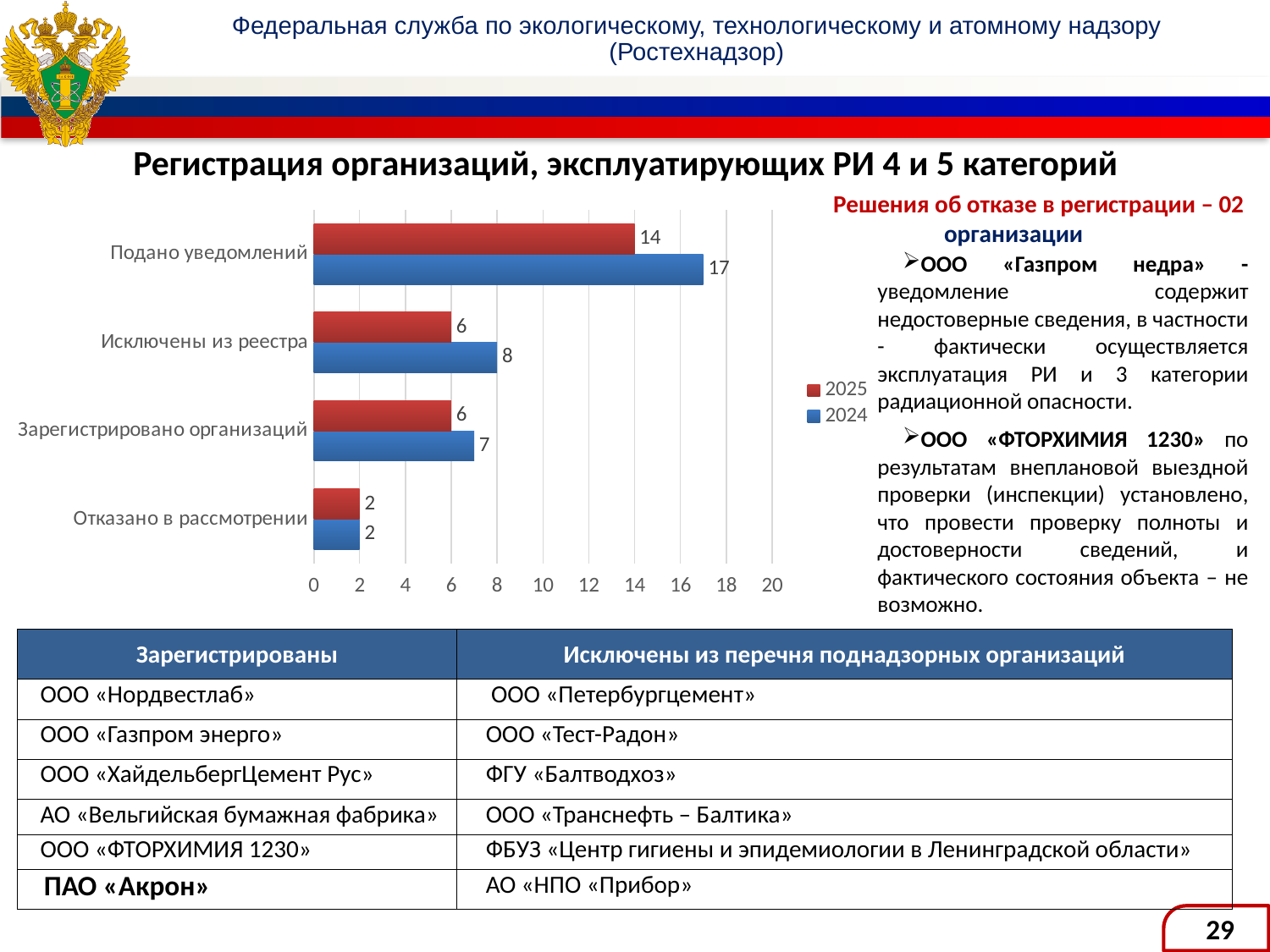
Which category has the lowest value in the 2025 series? Отказано в рассмотрении What type of chart is shown on the slide? bar chart How many categories are shown on the chart? 4 What is the value for 'Подано уведомлений' in the 2025 series? 14 How many series does the chart legend list? 2 Which is larger for 'Исключены из реестра': the 2024 value or the 2025 value? 2024 Which category has the highest value in the 2024 series? Подано уведомлений What is the value for 'Исключены из реестра' in the 2024 series? 8 What is the value for 'Подано уведомлений' in the 2024 series? 17 Which series is shown in red on the chart? 2025 What is the difference between the 2024 and 2025 values for 'Подано уведомлений'? 3 What is the value for 'Зарегистрировано организаций' in the 2025 series? 6